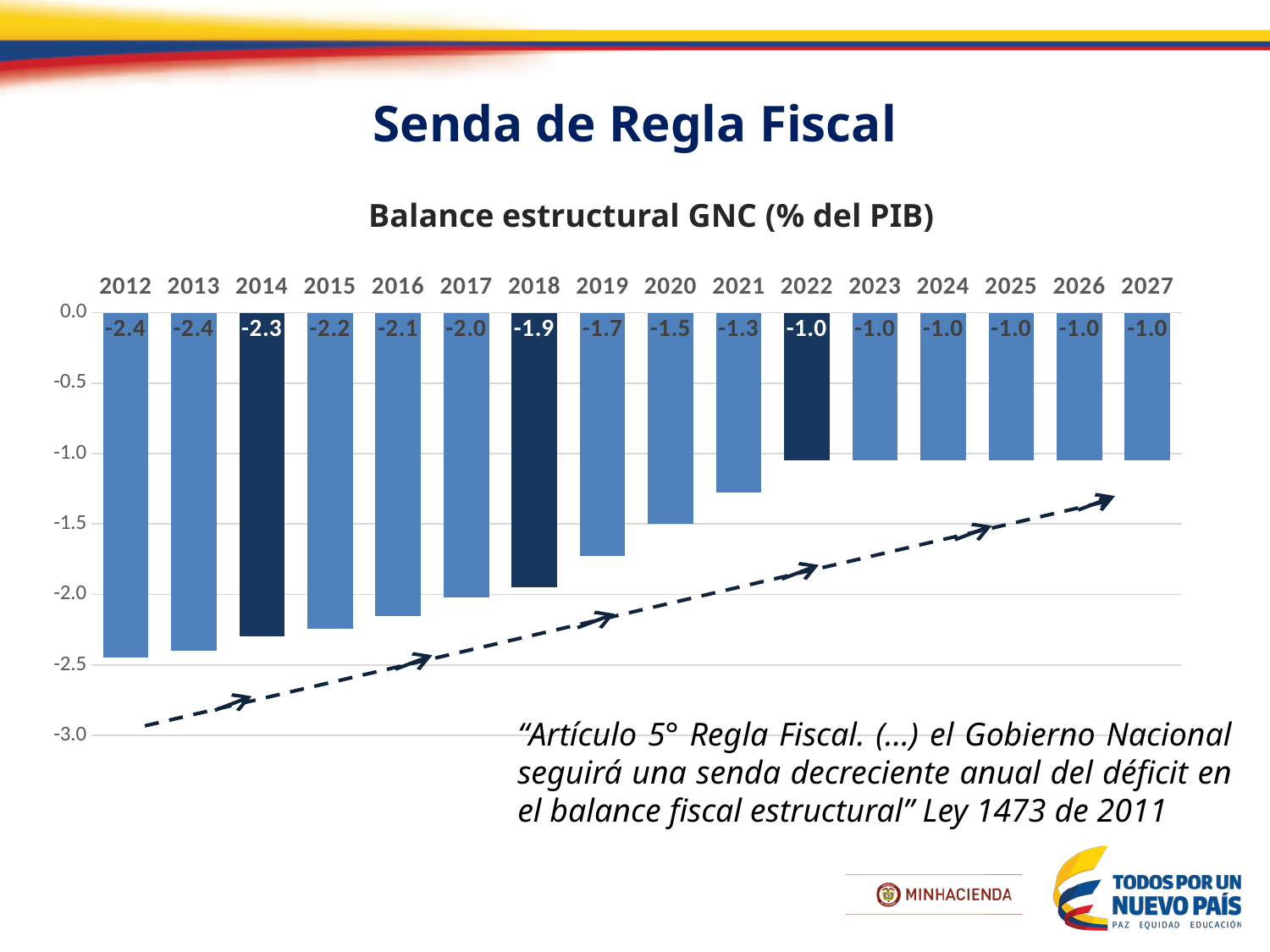
How many years are shown on the x axis? 16 What is the value for 2012? -2.4 Is the value for 2019 greater or less than -1.5? less What is the value for 2025? -1.0 What kind of chart is shown on the slide? bar chart What is the title of the chart? Balance estructural GNC (% del PIB) What is the difference between the values for 2017 and 2020? 0.5 What is the difference between the values for 2012 and 2022? 1.4 What is the value for 2018? -1.9 Do the values rise or fall from 2012 to 2027? rise Which is larger, the value for 2016 or the value for 2020? 2020 What is the value for 2021? -1.3